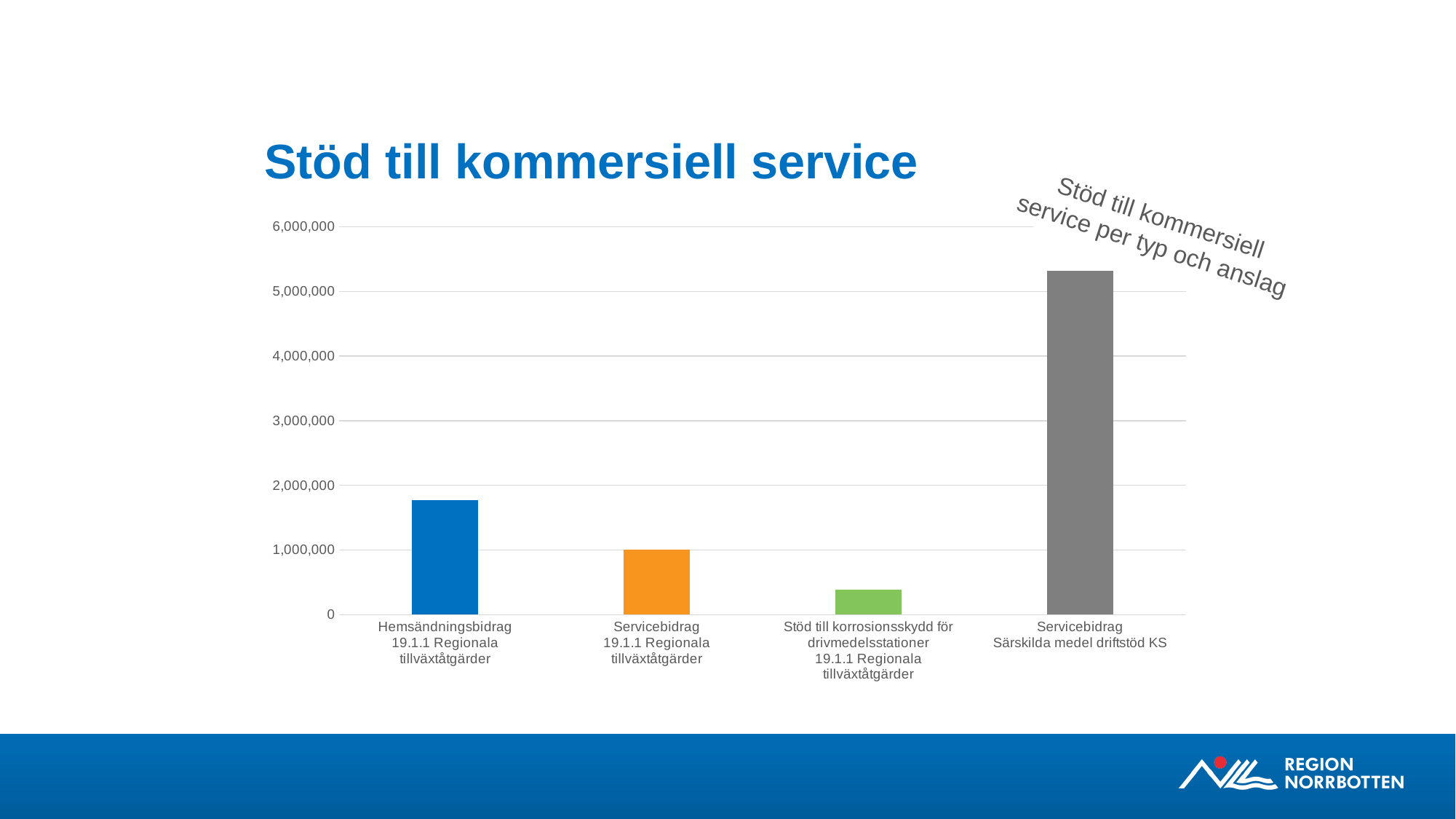
What colour is the bar for Servicebidrag Särskilda medel driftstöd KS? grey Is the value for Servicebidrag Särskilda medel driftstöd KS greater or less than 5,000,000? greater Which category has the lowest value? Stöd till korrosionsskydd för drivmedelsstationer 19.1.1 Regionala tillväxtåtgärder Which is larger: the value for Servicebidrag 19.1.1 Regionala tillväxtåtgärder or the value for Stöd till korrosionsskydd för drivmedelsstationer? Servicebidrag 19.1.1 Regionala tillväxtåtgärder What is the title of the slide? Stöd till kommersiell service Which category has the highest value? Servicebidrag Särskilda medel driftstöd KS Is the value for Hemsändningsbidrag 19.1.1 Regionala tillväxtåtgärder greater or less than 1,000,000? greater Is the value for Hemsändningsbidrag 19.1.1 Regionala tillväxtåtgärder greater or less than 2,000,000? less Which is larger: the value for Hemsändningsbidrag 19.1.1 Regionala tillväxtåtgärder or the value for Servicebidrag 19.1.1 Regionala tillväxtåtgärder? Hemsändningsbidrag 19.1.1 Regionala tillväxtåtgärder What kind of chart is shown on the slide? bar chart How many bars (categories) does the chart show? 4